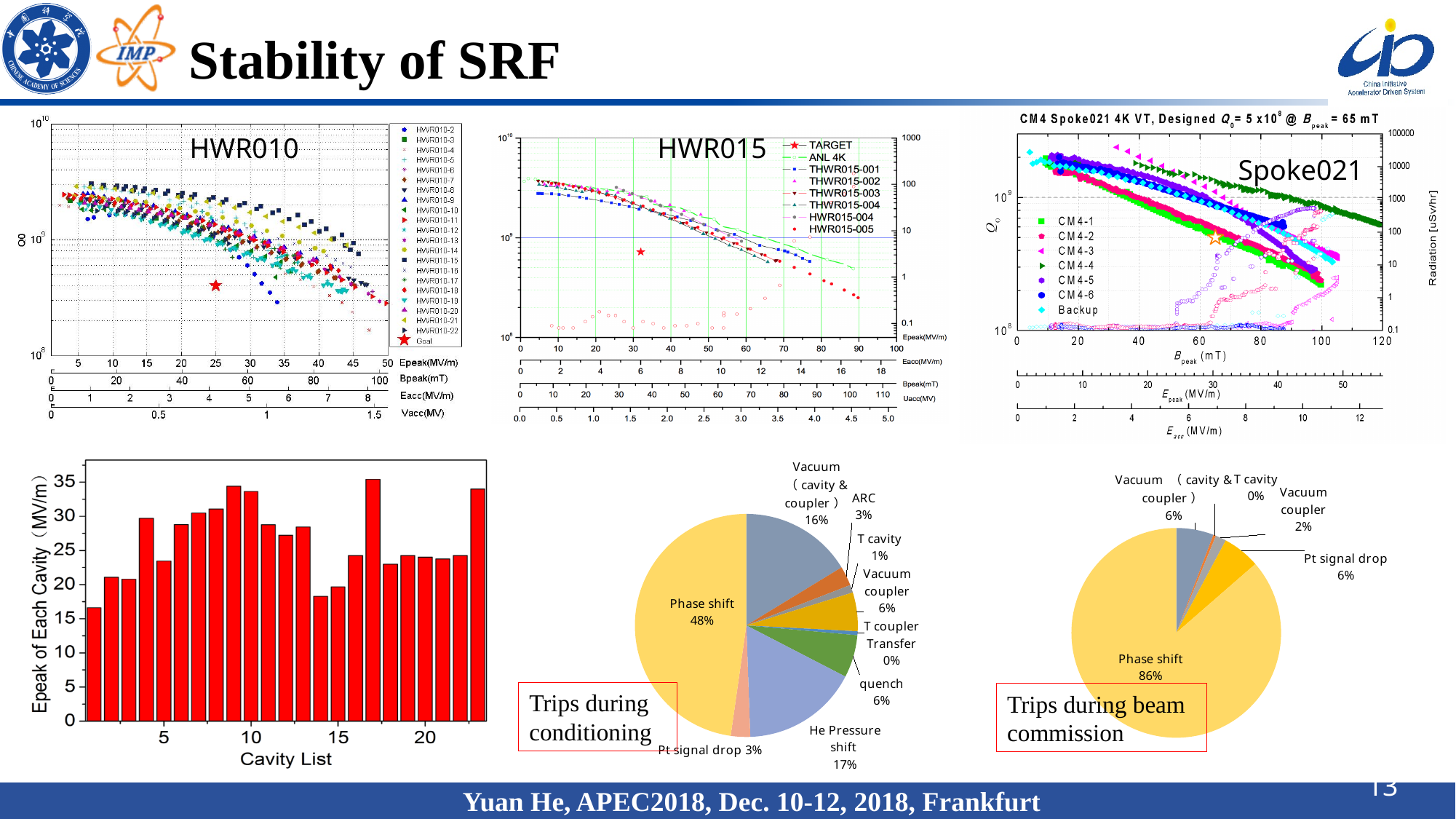
In the 'Epeak of Each Cavity' bar chart, is the value for cavity 1 greater or less than 20 MV/m? less What kind of chart is the 'Epeak of Each Cavity' chart at the bottom left? bar chart In the 'Trips during conditioning' pie chart, what share is He Pressure shift? 17% In the 'Epeak of Each Cavity' bar chart, is the value for cavity 9 greater or less than 30 MV/m? greater In the 'Trips during beam commission' pie chart, what share is Vacuum coupler? 2% In the 'Epeak of Each Cavity' bar chart, how many cavities are plotted? 23 In the 'Trips during beam commission' pie chart, what share is Phase shift? 86% In the 'Trips during conditioning' pie chart, what is the difference between the Vacuum (cavity & coupler) share and the quench share? 10% In the 'Trips during conditioning' pie chart, what share is Phase shift? 48% In the 'Trips during beam commission' pie chart, which is larger, Vacuum (cavity & coupler) or Vacuum coupler? Vacuum (cavity & coupler) In the 'Trips during conditioning' pie chart, which category has the largest share? Phase shift How many series does the legend of the Spoke021 chart list? 7